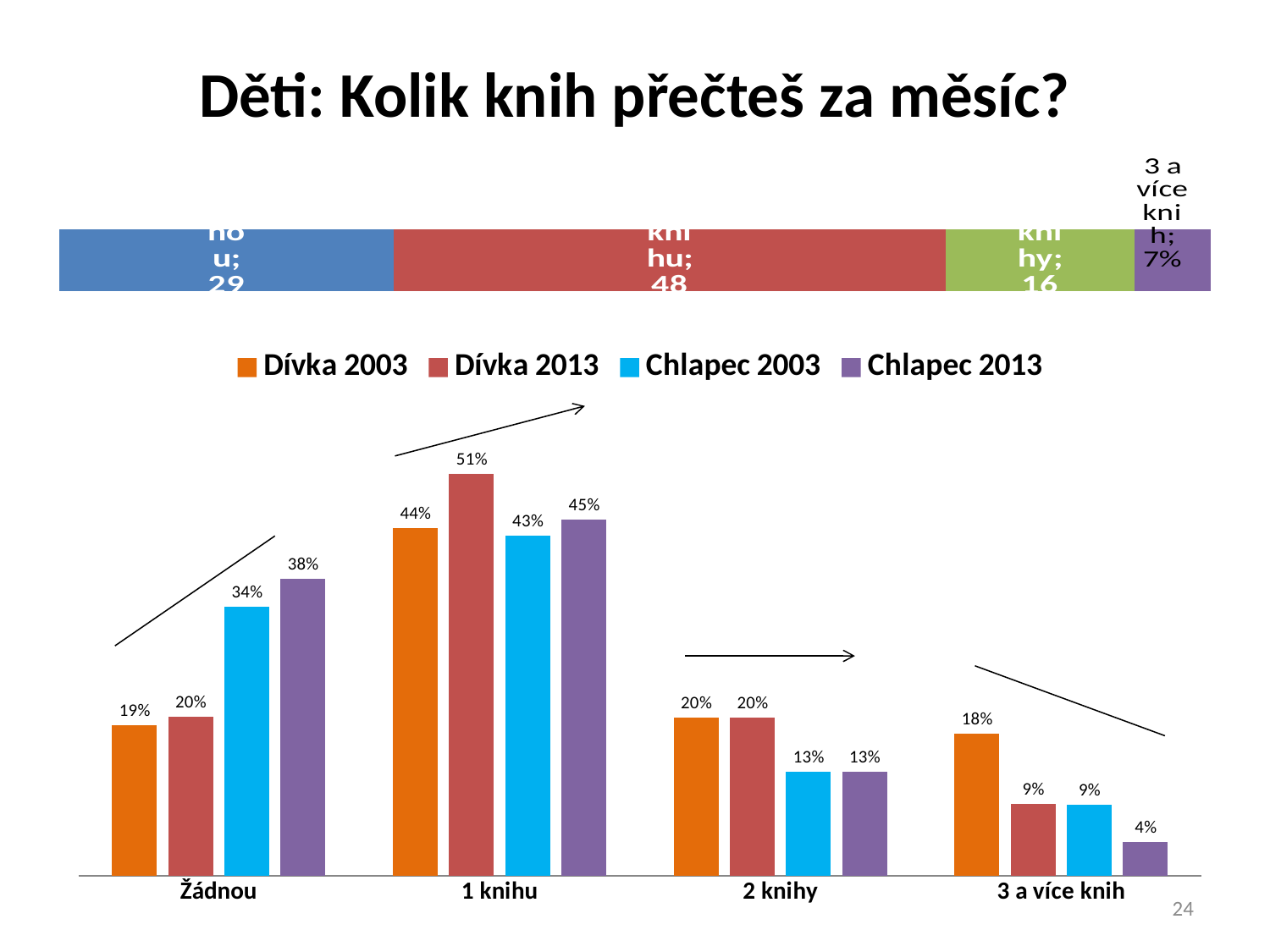
In the lower grouped bar chart, which is larger in the '3 a více knih' category: Dívka 2003 or Dívka 2013? Dívka 2003 In the lower grouped bar chart, what is the difference between Chlapec 2013 and Dívka 2003 in the 'Žádnou' category? 19% In the lower grouped bar chart, what is the value for Chlapec 2013 in the 'Žádnou' category? 38% In the lower grouped bar chart, what is the value for Chlapec 2003 in the '2 knihy' category? 13% In the lower grouped bar chart, which series has the highest value in the '1 knihu' category? Dívka 2013 What kind of chart is the lower chart on the slide? Bar chart In the lower grouped bar chart, what is the value for Dívka 2013 in the '1 knihu' category? 51% In the lower grouped bar chart, what is the value for Dívka 2003 in the '3 a více knih' category? 18% How many categories are shown on the x axis of the lower grouped bar chart? 4 How many series does the legend of the lower grouped bar chart list? 4 In the top stacked bar chart, what percentage is shown for the '3 a více knih' segment? 7% In the lower grouped bar chart, which series has the lowest value in the '3 a více knih' category? Chlapec 2013